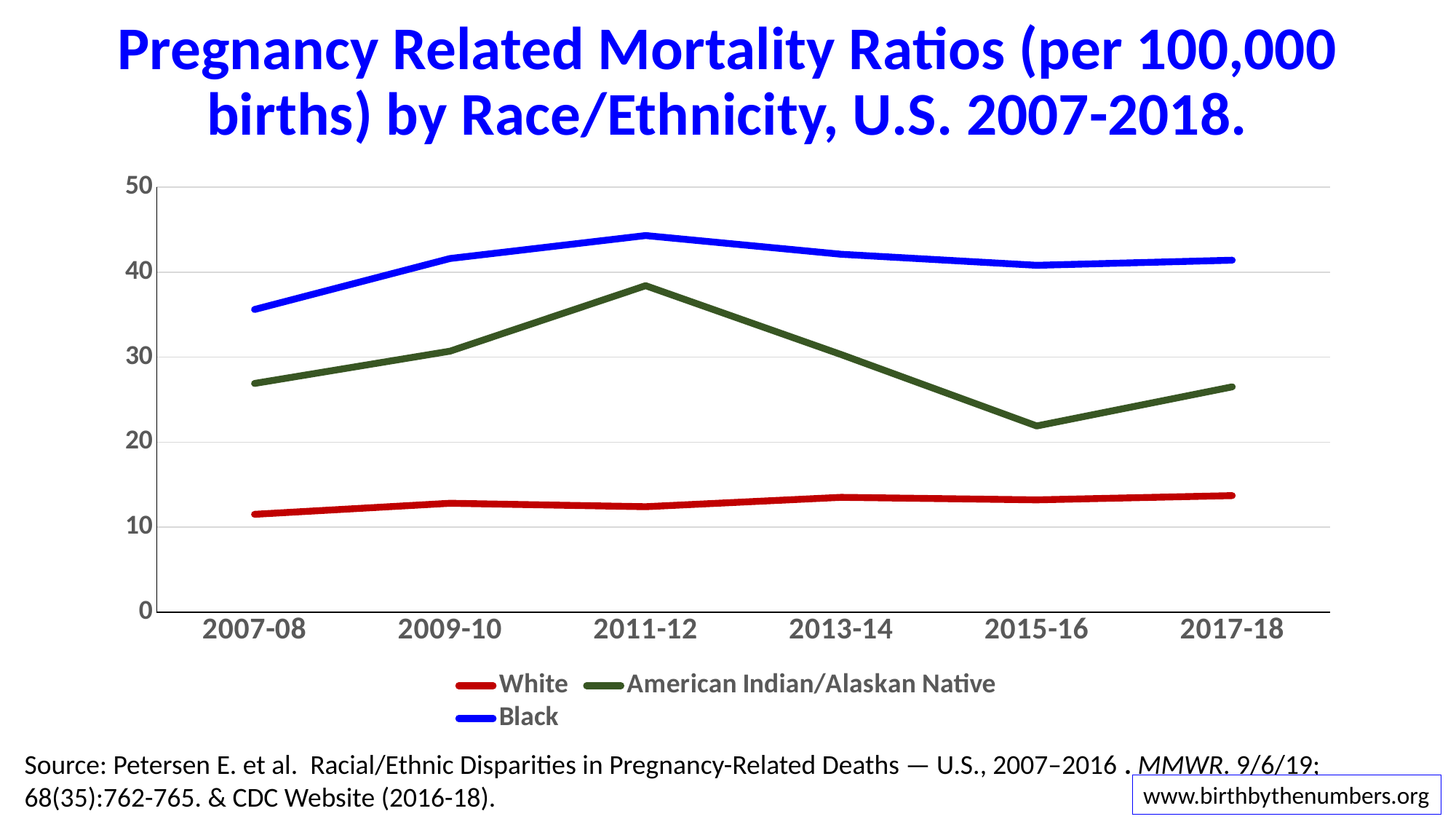
How many series does the legend list? 3 Which series has the lowest values across all periods? White What colour is the line for Black? blue Which series has the larger value in 2013-14, Black or American Indian/Alaskan Native? Black Is the value for Black in 2011-12 greater or less than 40? greater How many time periods are shown on the x axis? 6 In which period is the value for Black highest? 2011-12 Is the value for American Indian/Alaskan Native in 2015-16 greater or less than 30? less What kind of chart is shown on the slide? line chart In which period is the value for American Indian/Alaskan Native highest? 2011-12 In which period is the value for American Indian/Alaskan Native lowest? 2015-16 Is the value for Black in 2007-08 greater or less than 40? less